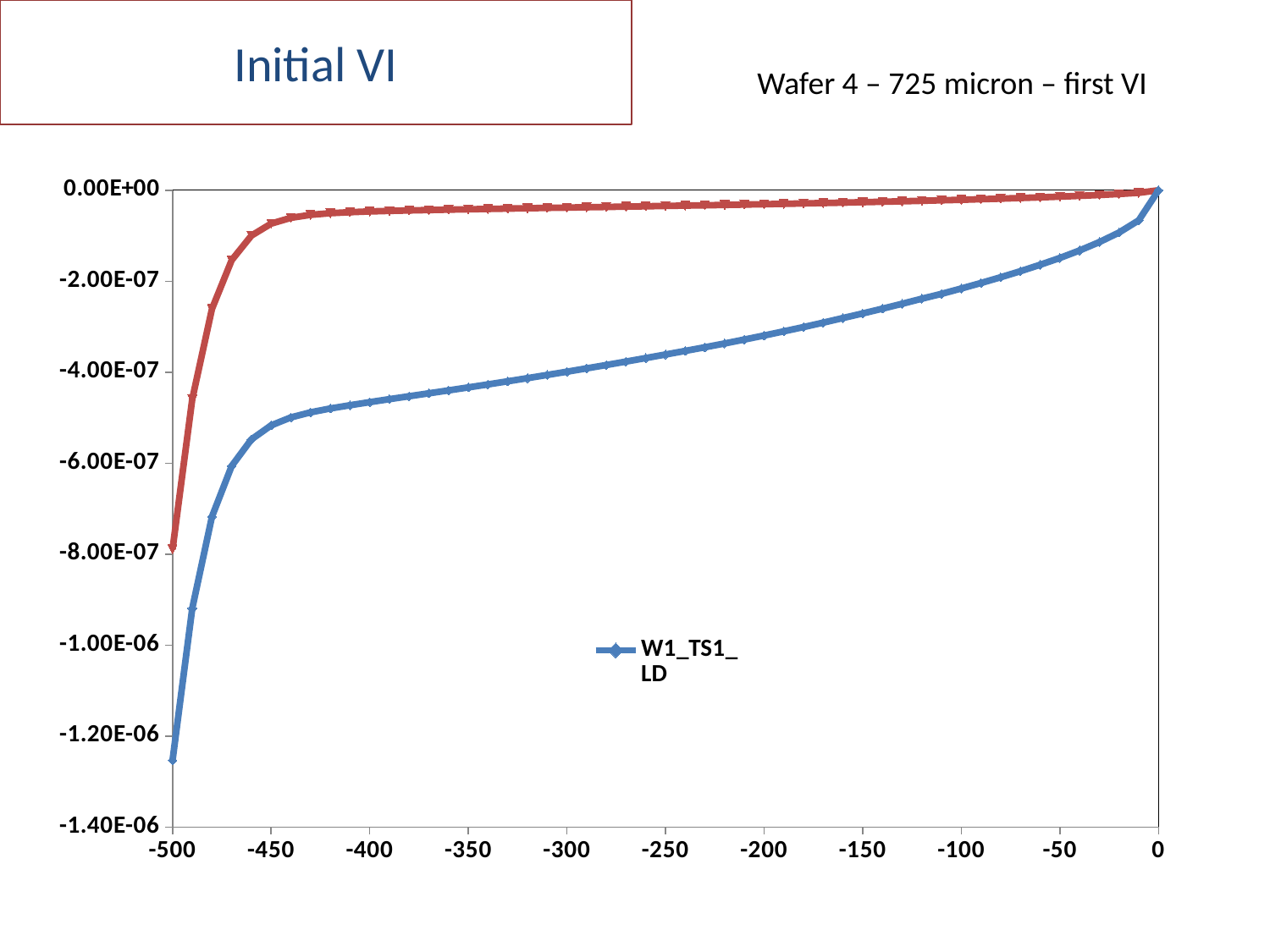
How many lines are plotted on the chart? 2 What is the lowest value shown on the y axis? -1.40E-06 What kind of chart is shown on the slide? line chart What is the name of the series listed in the legend? W1_TS1_LD Do the values of the blue line rise or fall as x goes from -500 to 0? rise Is the value of the blue line at x = -400 greater or less than -4.00E-07? less At x = -500, which line has the lower value, the blue line or the red line? the blue line Is the value of the blue line at x = -500 greater or less than -1.20E-06? less Is the value of the red line at x = -400 greater or less than -2.00E-07? greater How many series does the legend list? 1